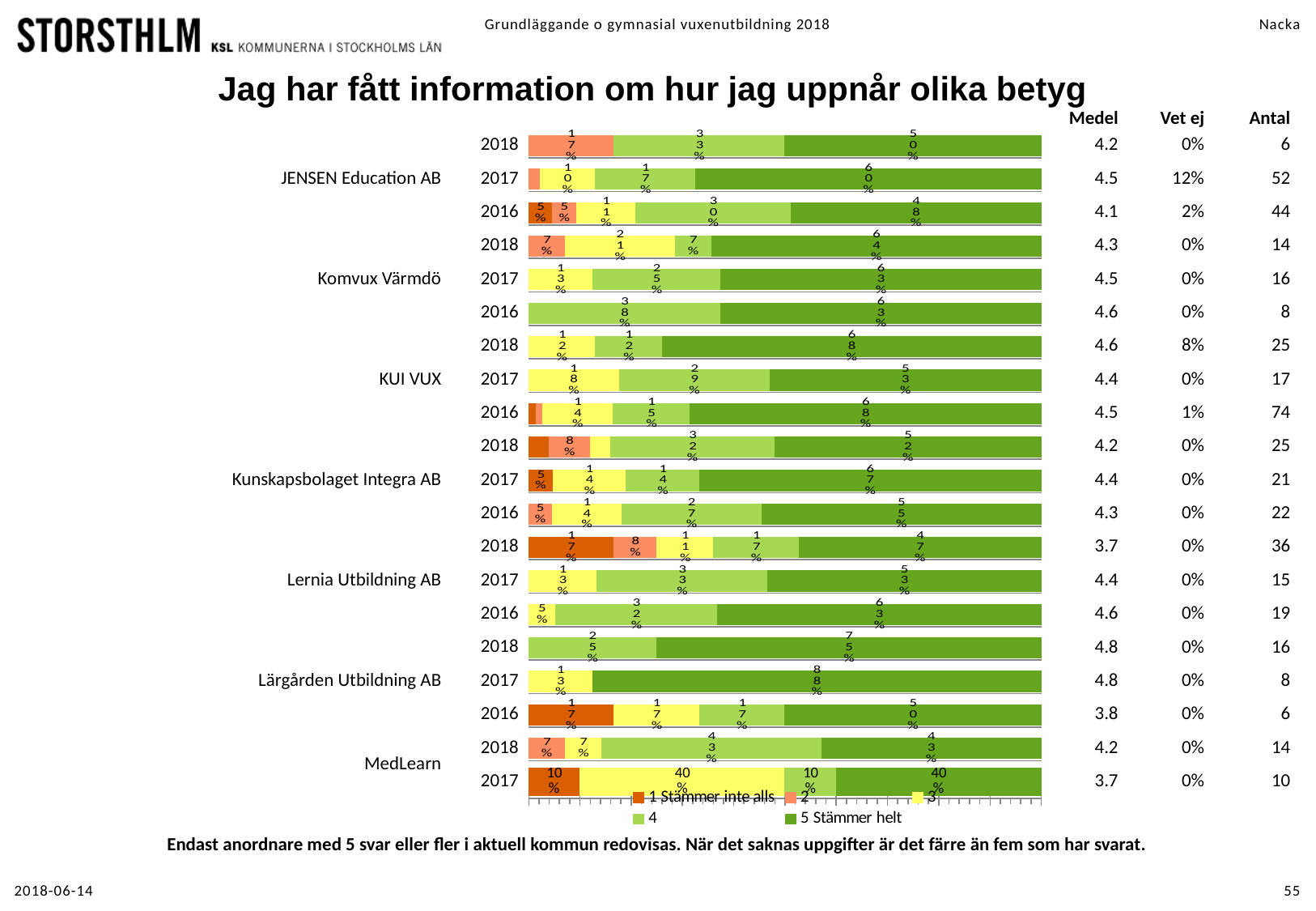
What kind of chart is shown on the slide? Stacked bar chart What is the share for '4' for MedLearn in 2018? 43% What is the title of the chart? Jag har fått information om hur jag uppnår olika betyg What is the share for '5 Stämmer helt' for KUI VUX in 2018? 68% What is the share for '5 Stämmer helt' for Lärgården Utbildning AB in 2017? 88% For Komvux Värmdö in 2016, which is larger: the share for '4' or the share for '5 Stämmer helt'? 5 Stämmer helt How many education providers are shown in the chart? 7 What is the share for '1 Stämmer inte alls' for Lernia Utbildning AB in 2018? 17% For Lärgården Utbildning AB in 2018, what is the difference between the share for '5 Stämmer helt' and the share for '4'? 50 percentage points How many series does the chart legend list? 5 Which provider-year bar has the highest share for '5 Stämmer helt'? Lärgården Utbildning AB 2017